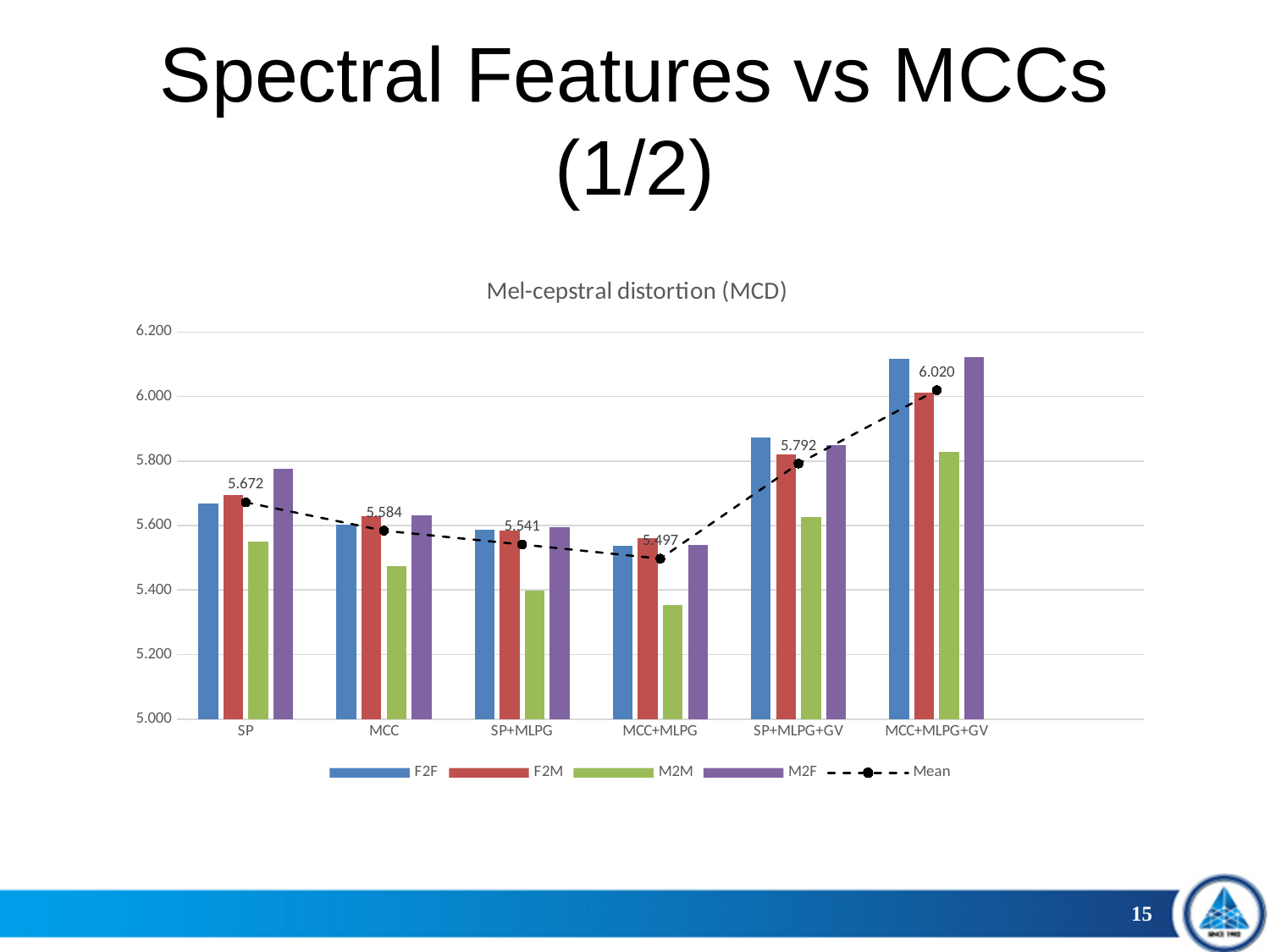
What is the Mean value for MCC+MLPG+GV? 6.020 What is the title of the chart? Mel-cepstral distortion (MCD) Which is larger for SP: the M2M value or the M2F value? M2F Is the M2M value for MCC+MLPG greater or less than 5.400? less How many categories are shown on the x axis? 6 What is the Mean value for MCC+MLPG? 5.497 What is the difference between the Mean values for MCC+MLPG+GV and MCC+MLPG? 0.523 How many series does the legend list? 5 Is the F2F value for MCC+MLPG+GV greater or less than 6.000? greater Which category has the lowest Mean value? MCC+MLPG What is the Mean value for SP? 5.672 Which category has the highest Mean value? MCC+MLPG+GV